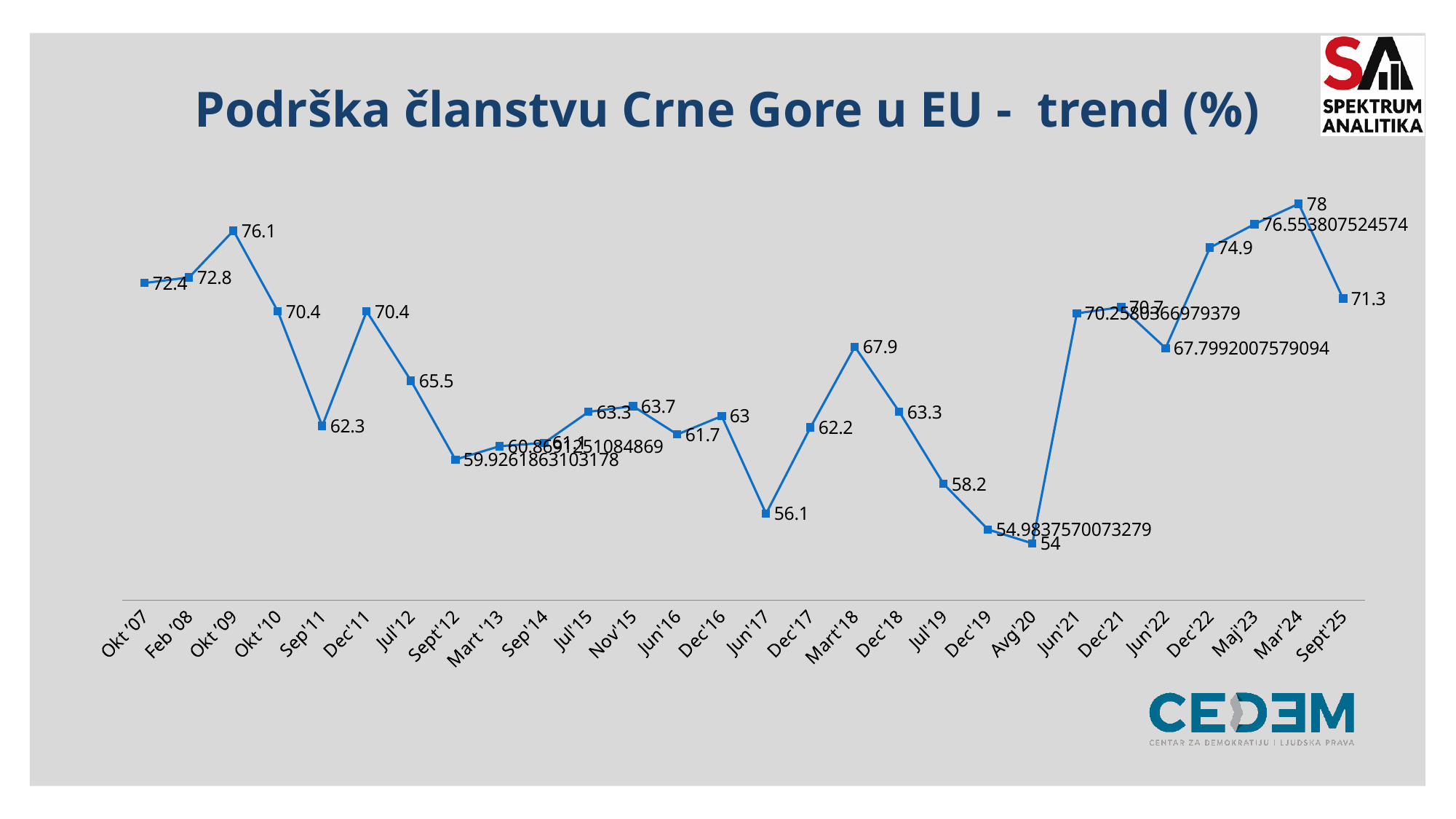
How many data points are plotted on the chart? 28 What is the difference between the values for Mar'24 and Sept'25? 6.7 Which period has the highest value? Mar'24 Which is larger, the value for Okt '09 or the value for Dec'22? Okt '09 What is the title of the chart? Podrška članstvu Crne Gore u EU - trend (%) What is the value for Sept'25? 71.3 What type of chart is shown on the slide? Line chart What is the value for Okt '09? 76.1 Do the values rise or fall from Dec'22 to Mar'24? Rise What is the value for Mart'18? 67.9 What is the value for Jun'17? 56.1 Which period has the lowest value? Avg'20